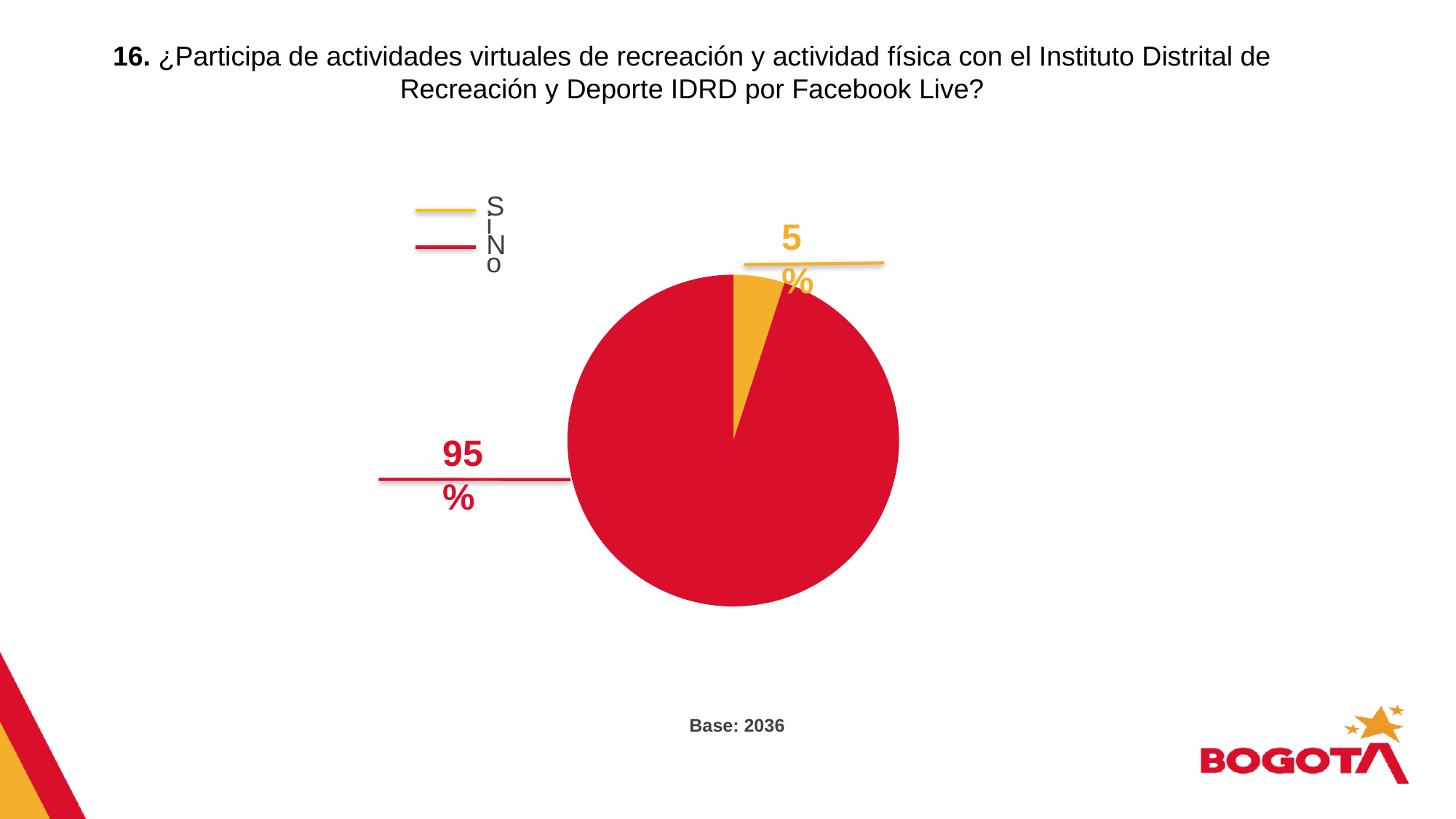
Which slice is larger, "Si" or "No"? No What colour is the "No" slice? red What percentage of respondents answered "No"? 95% What is the base (number of respondents) shown below the chart? 2036 Which response has the smallest share of the pie? Si How many entries does the legend list? 2 What kind of chart is shown on the slide? pie chart How many slices does the pie chart have? 2 What percentage of respondents answered "Si"? 5% Which response has the largest share of the pie? No What is the difference in percentage points between the "No" and "Si" slices? 90